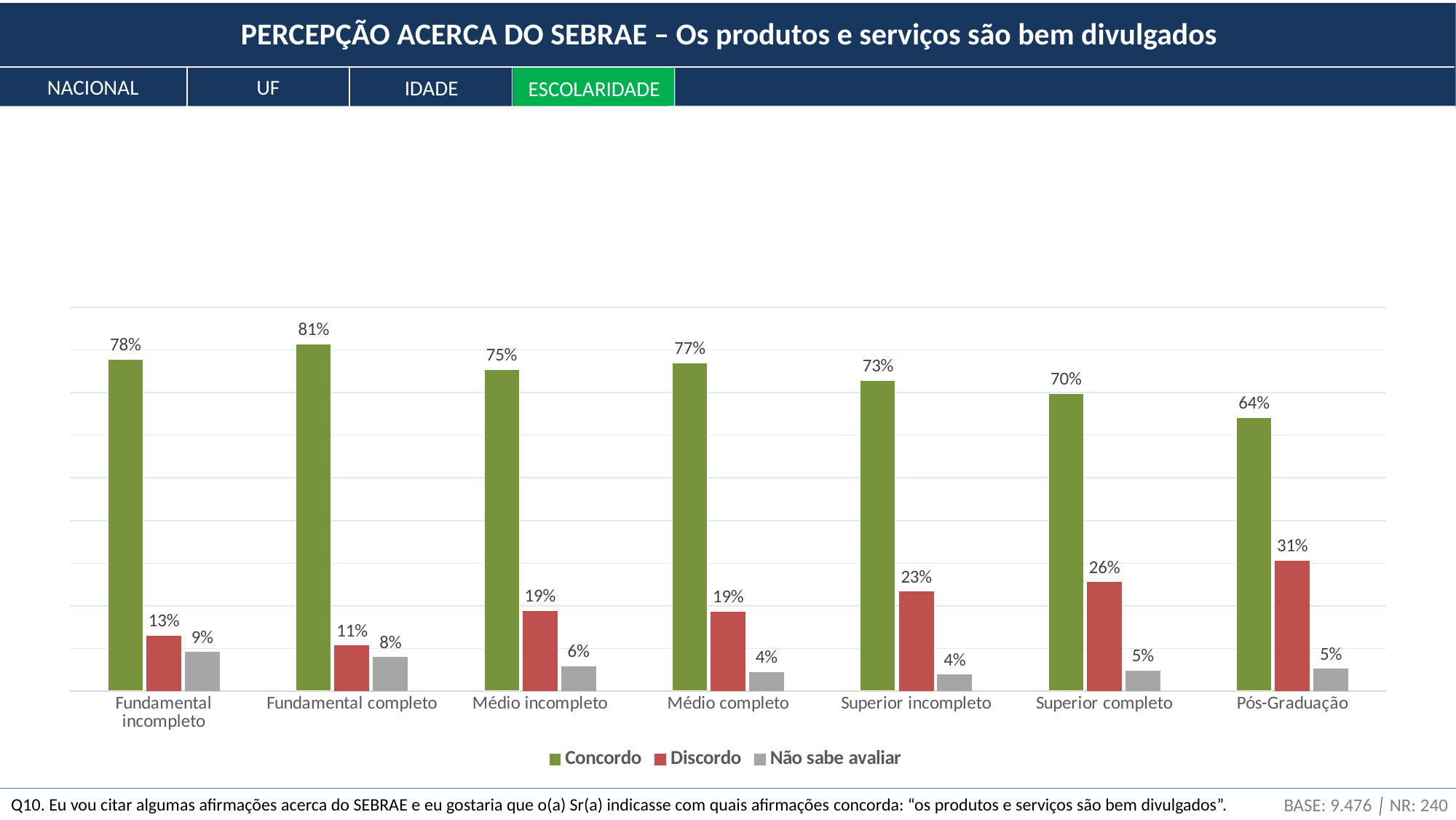
Do the Discordo values rise or fall from Médio incompleto to Pós-Graduação along the x axis? Rise Which is larger, the Discordo value for Superior completo or for Superior incompleto? Superior completo Which education category has the highest Concordo value? Fundamental completo Which education category has the highest Discordo value? Pós-Graduação How many series does the legend list? 3 How many education categories are shown on the x axis? 7 What is the difference between the Concordo values for Fundamental completo and Pós-Graduação? 17% Which education category has the lowest Concordo value? Pós-Graduação What kind of chart is shown on the slide? Bar chart What is the Concordo value for Fundamental completo? 81% What is the Não sabe avaliar value for Fundamental incompleto? 9% What is the Discordo value for Pós-Graduação? 31%